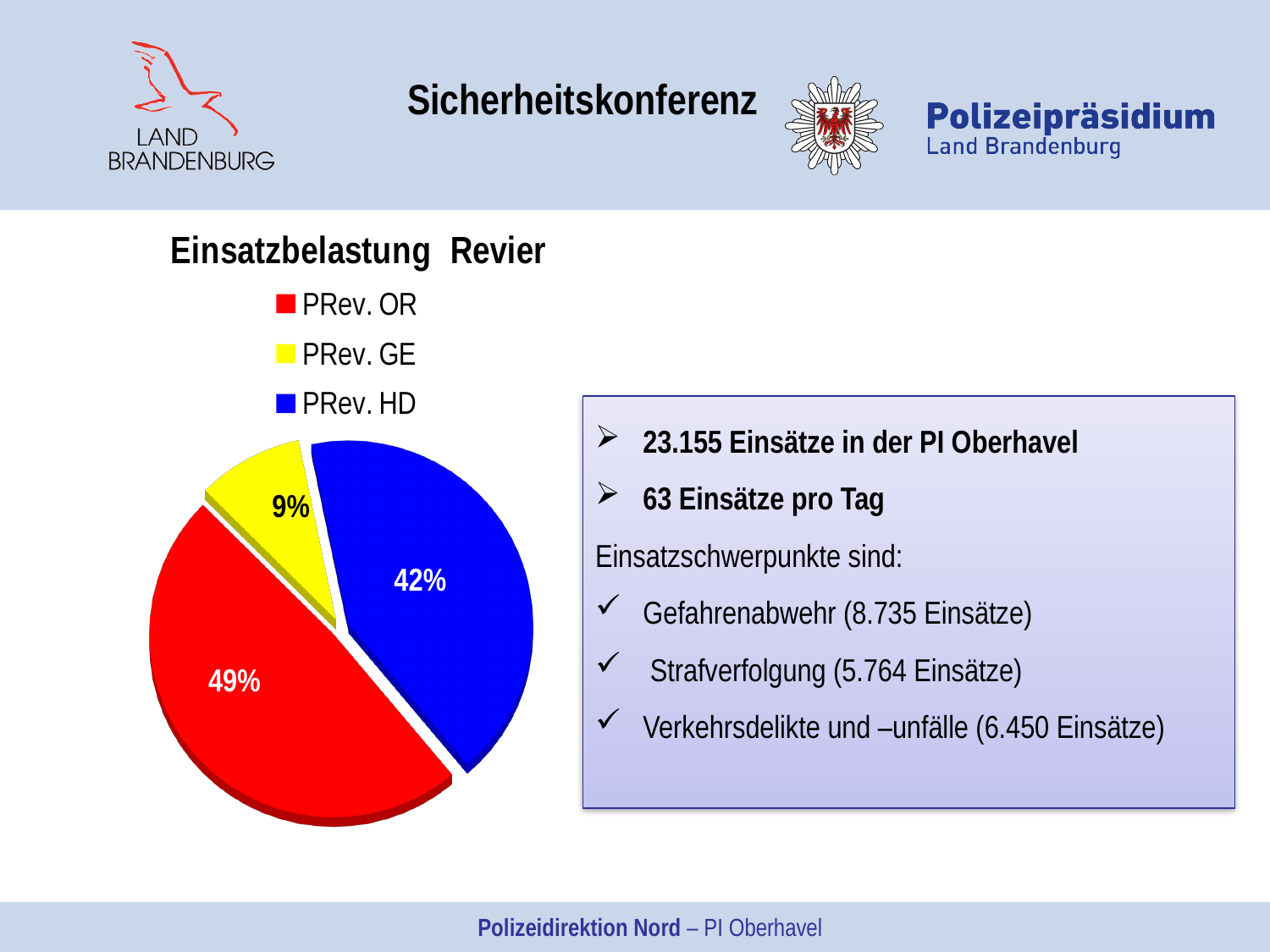
What type of chart is shown on the slide? pie chart What share of the pie does PRev. OR have? 49% Which colour represents PRev. GE in the pie chart? yellow Which is larger, the share for PRev. HD or the share for PRev. GE? PRev. HD What share of the pie does PRev. HD have? 42% What is the title of the chart? Einsatzbelastung Revier How many entries does the legend list? 3 How many slices does the pie chart have? 3 What share of the pie does PRev. GE have? 9% Which category has the largest share of the pie? PRev. OR What is the difference in percentage points between PRev. OR and PRev. HD? 7 Which category has the smallest share of the pie? PRev. GE